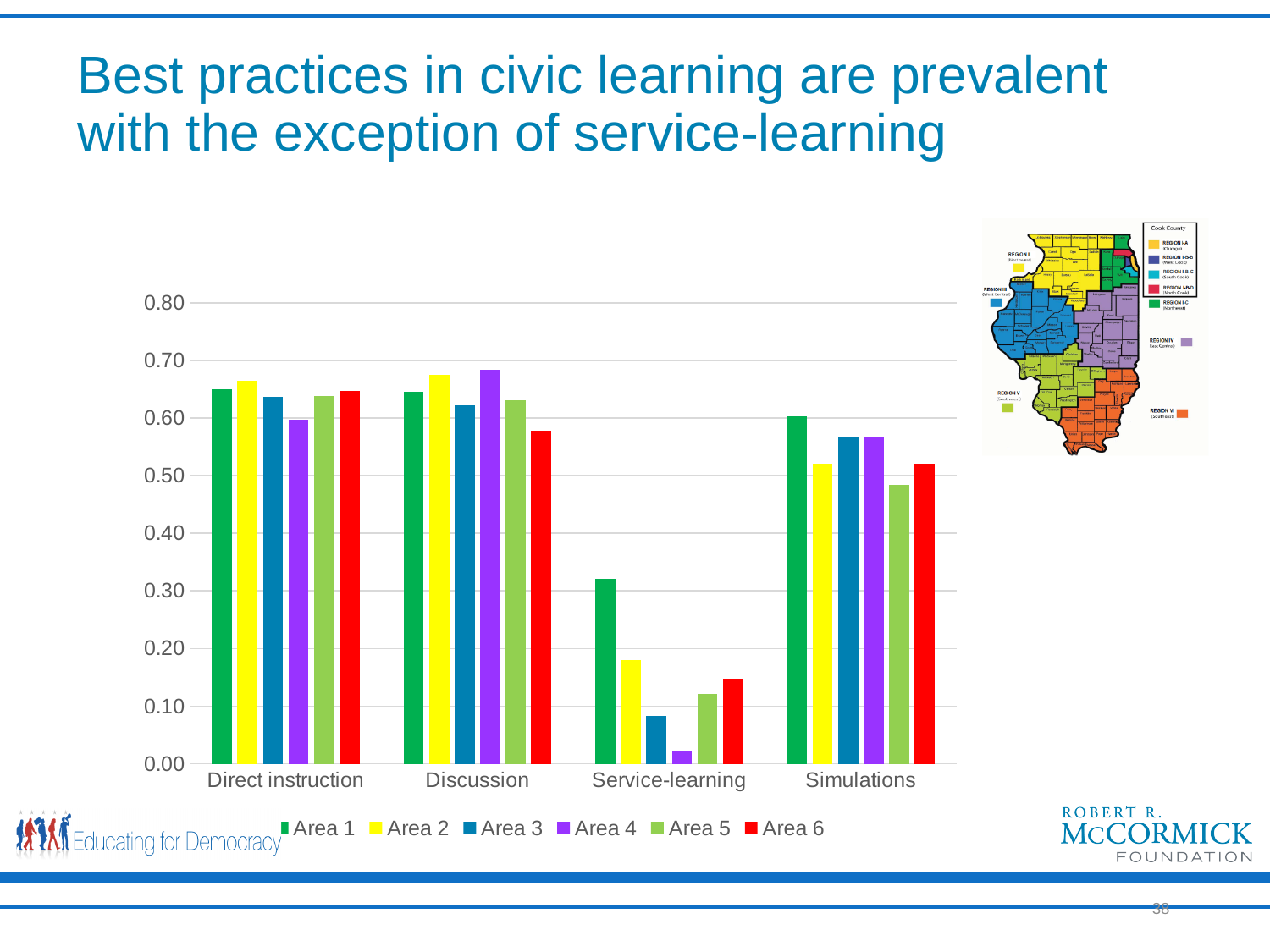
Is the value for Area 6 in Discussion greater or less than 0.60? less Which area has the highest value for Service-learning? Area 1 Is the value for Area 1 in Service-learning greater or less than 0.20? greater Is the value for Area 4 in Service-learning greater or less than 0.10? less How many categories are shown on the x axis of the chart? 4 Which area has the lowest value for Service-learning? Area 4 In Simulations, which is larger: the value for Area 1 or the value for Area 5? Area 1 What kind of chart is shown on the slide? bar chart How many series does the chart's legend list? 6 What colour represents Area 6 in the chart's legend? red Which area has the lowest value for Simulations? Area 5